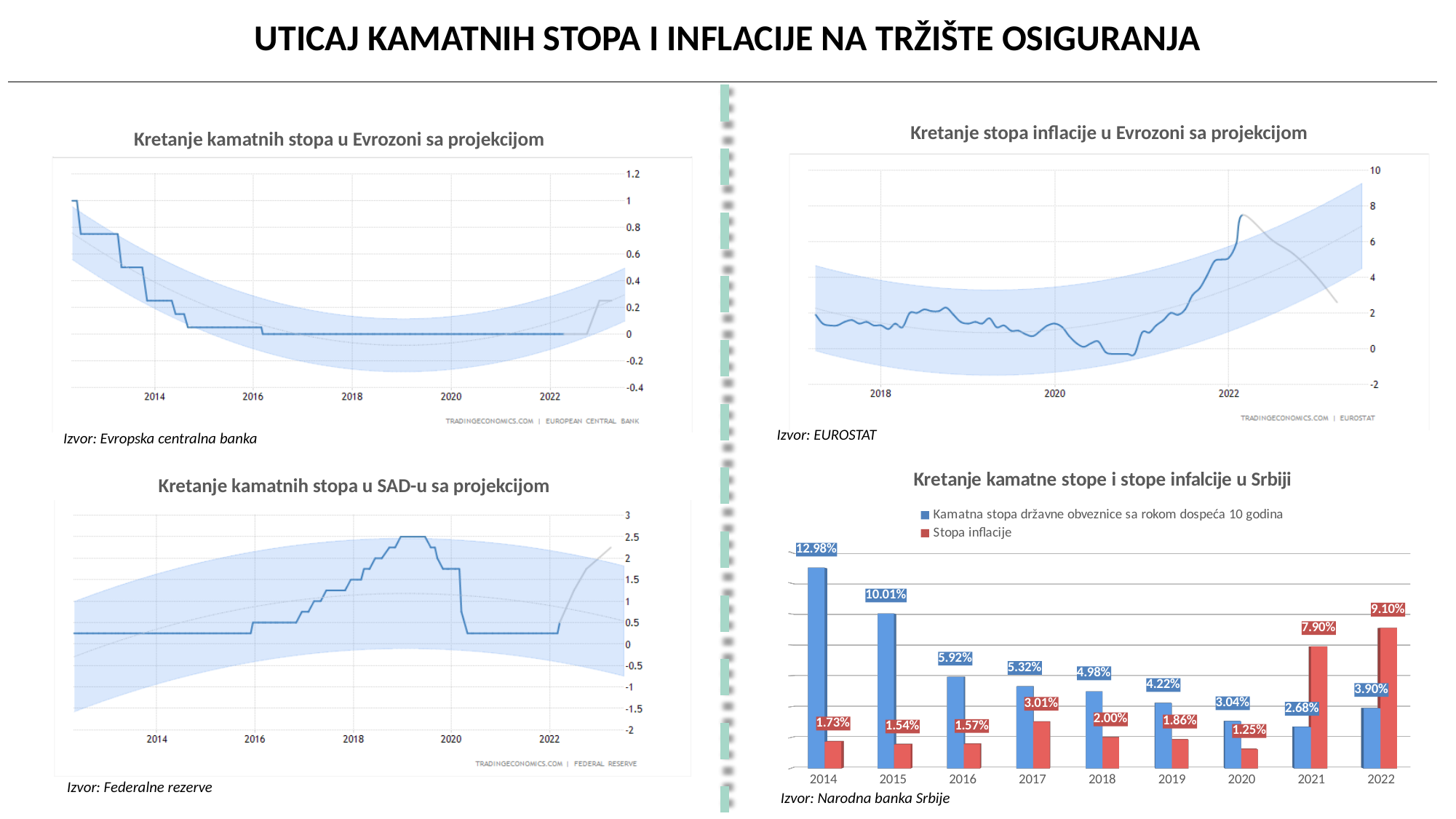
What kind of chart is 'Kretanje kamatnih stopa u SAD-u sa projekcijom'? Line chart In the chart 'Kretanje kamatne stope i stope infalcije u Srbiji', which year has the lowest inflation rate? 2020 In the chart 'Kretanje kamatne stope i stope infalcije u Srbiji', what is the inflation rate in 2022? 9.10% In the chart 'Kretanje kamatne stope i stope infalcije u Srbiji', what is the difference between the inflation rate in 2022 and in 2021? 1.20% How many years are shown on the x axis of the chart 'Kretanje kamatne stope i stope infalcije u Srbiji'? 9 How many series does the legend of the chart 'Kretanje kamatne stope i stope infalcije u Srbiji' list? 2 In the chart 'Kretanje kamatnih stopa u Evrozoni sa projekcijom', do the interest rates rise or fall between 2013 and 2016? Fall In the chart 'Kretanje kamatne stope i stope infalcije u Srbiji', which is larger in 2021: the interest rate on 10-year government bonds or the inflation rate? Stopa inflacije In the chart 'Kretanje kamatne stope i stope infalcije u Srbiji', which year has the highest interest rate on 10-year government bonds? 2014 What kind of chart is 'Kretanje kamatne stope i stope infalcije u Srbiji'? Bar chart In the chart 'Kretanje stopa inflacije u Evrozoni sa projekcijom', is the peak value reached in 2022 greater or less than 6? greater In the chart 'Kretanje kamatne stope i stope infalcije u Srbiji', what is the interest rate on 10-year government bonds in 2014? 12.98%